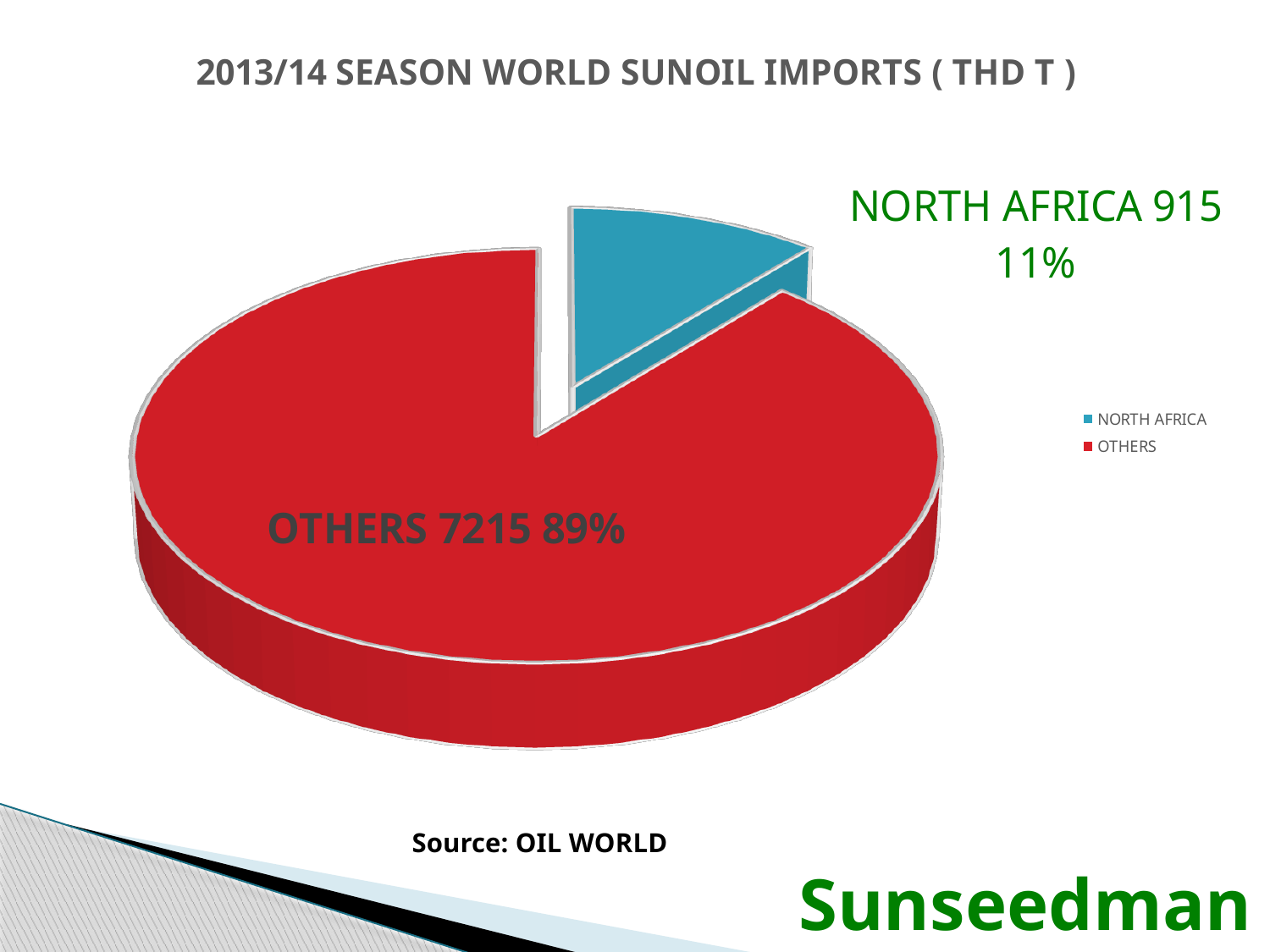
What is the difference between the values for OTHERS and NORTH AFRICA? 6300 What colour is the NORTH AFRICA slice? blue What is the title of the chart? 2013/14 SEASON WORLD SUNOIL IMPORTS ( THD T ) How many categories does the pie chart have? 2 What is the value for NORTH AFRICA? 915 What share of the pie does NORTH AFRICA represent? 11% Which category has the smallest slice? NORTH AFRICA What share of the pie does OTHERS represent? 89% Which category has the largest slice? OTHERS What kind of chart is shown on the slide? pie chart What is the value for OTHERS? 7215 Which is larger, the value for NORTH AFRICA or the value for OTHERS? OTHERS